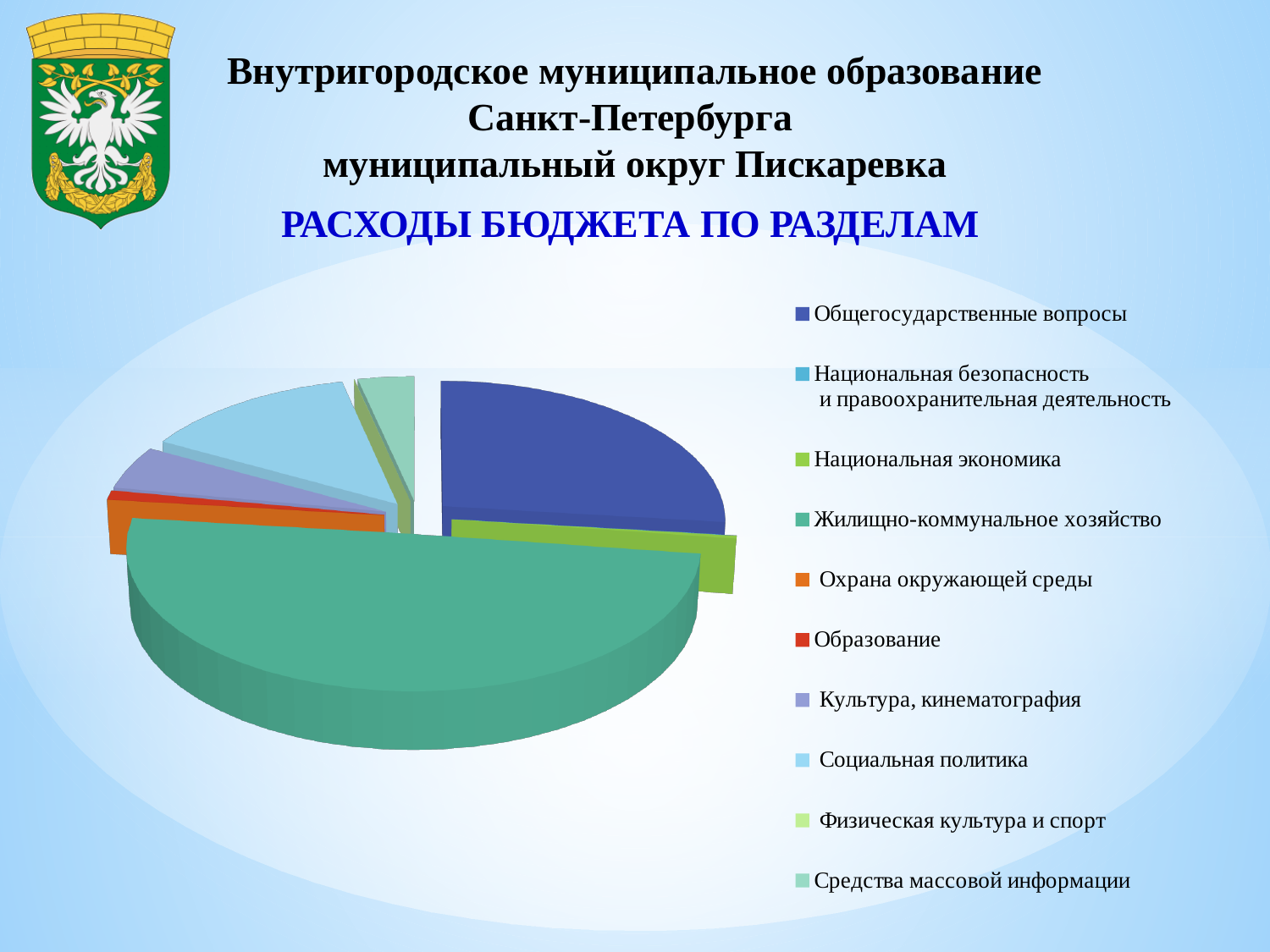
What kind of chart is shown on the slide? pie chart What is the title of the chart? РАСХОДЫ БЮДЖЕТА ПО РАЗДЕЛАМ Which category is shown in dark blue in the legend? Общегосударственные вопросы Which slice is larger: Жилищно-коммунальное хозяйство or Охрана окружающей среды? Жилищно-коммунальное хозяйство Which slice is larger: Общегосударственные вопросы or Социальная политика? Общегосударственные вопросы Which slice is larger: Социальная политика or Образование? Социальная политика How many categories does the legend of the pie chart list? 10 Which category has the largest slice of the pie chart? Жилищно-коммунальное хозяйство